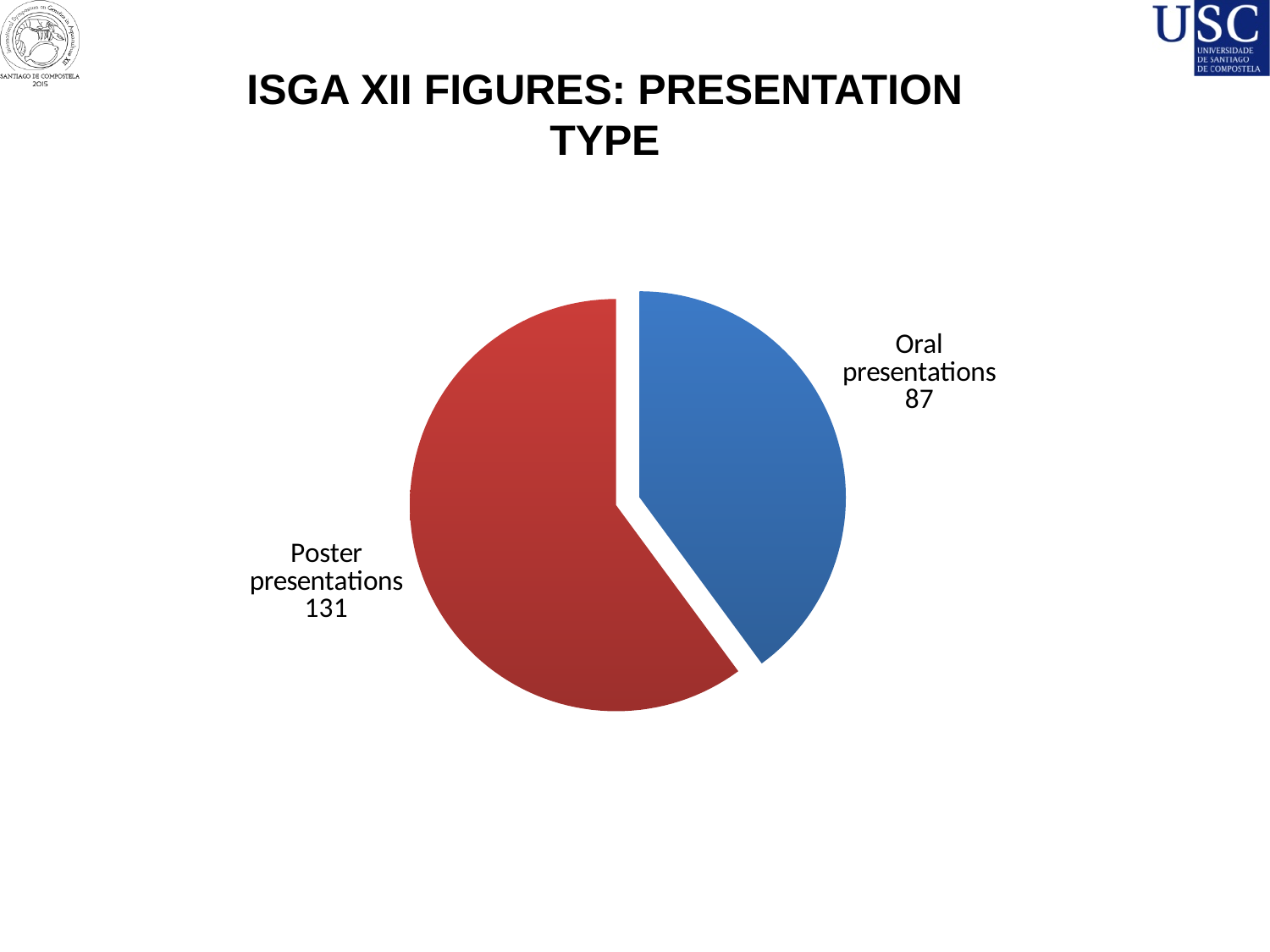
Which presentation type has the largest slice of the pie? Poster presentations Which presentation type has the smallest slice of the pie? Oral presentations What share of all presentations are poster presentations, to the nearest whole percent? 60% What is the total number of presentations shown in the pie chart? 218 What kind of chart is shown on the slide? pie chart How many poster presentations are shown in the pie chart? 131 Which is larger, the number of oral presentations or the number of poster presentations? Poster presentations What share of all presentations are oral presentations, to the nearest whole percent? 40% How many slices does the pie chart have? 2 What colour is the slice for oral presentations? blue How many more poster presentations than oral presentations are there? 44 How many oral presentations are shown in the pie chart? 87